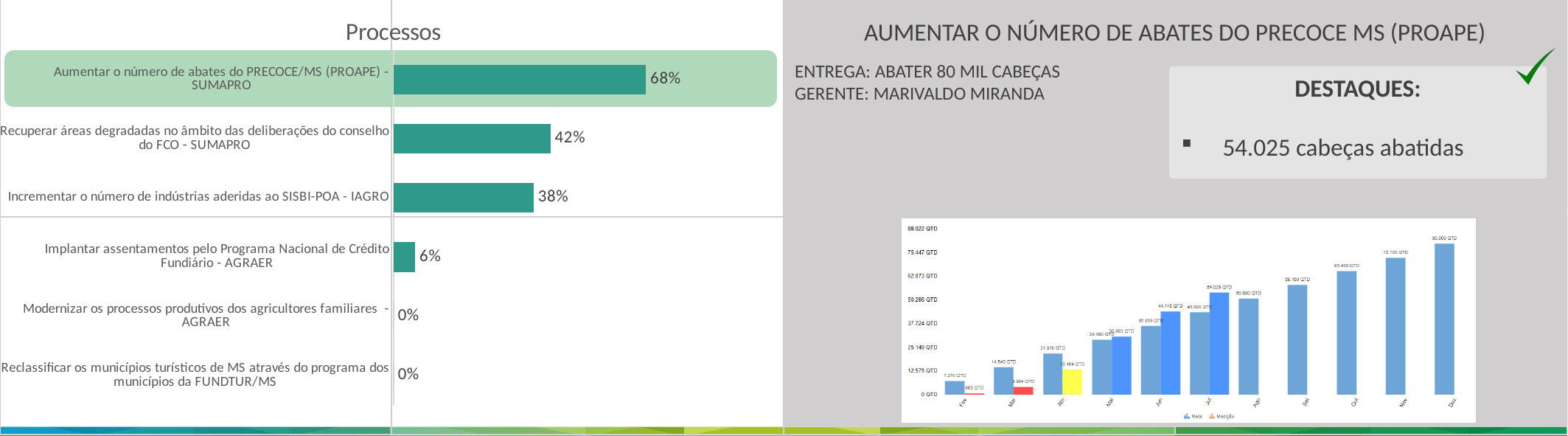
In the 'Processos' chart, what is the value for 'Implantar assentamentos pelo Programa Nacional de Crédito Fundiário - AGRAER'? 6% In the 'Processos' chart, how many categories have a value of 0%? 2 In the 'Processos' chart, what is the value for 'Incrementar o número de indústrias aderidas ao SISBI-POA - IAGRO'? 38% In the 'Processos' chart, what is the difference between the values for 'Aumentar o número de abates do PRECOCE/MS (PROAPE) - SUMAPRO' and 'Recuperar áreas degradadas no âmbito das deliberações do conselho do FCO - SUMAPRO'? 26% What kind of chart is the chart on the right side of the slide, below 'DESTAQUES'? Bar chart What kind of chart is the 'Processos' chart? Bar chart In the 'Processos' chart, which category has the highest value? Aumentar o número de abates do PRECOCE/MS (PROAPE) - SUMAPRO In the 'Processos' chart, what is the value for 'Modernizar os processos produtivos dos agricultores familiares - AGRAER'? 0% In the 'Processos' chart, which is larger: the value for 'Recuperar áreas degradadas no âmbito das deliberações do conselho do FCO - SUMAPRO' or for 'Incrementar o número de indústrias aderidas ao SISBI-POA - IAGRO'? Recuperar áreas degradadas no âmbito das deliberações do conselho do FCO - SUMAPRO In the 'Processos' chart, what is the value for 'Recuperar áreas degradadas no âmbito das deliberações do conselho do FCO - SUMAPRO'? 42% In the 'Processos' chart, what is the value for 'Aumentar o número de abates do PRECOCE/MS (PROAPE) - SUMAPRO'? 68% How many categories are shown in the 'Processos' chart? 6